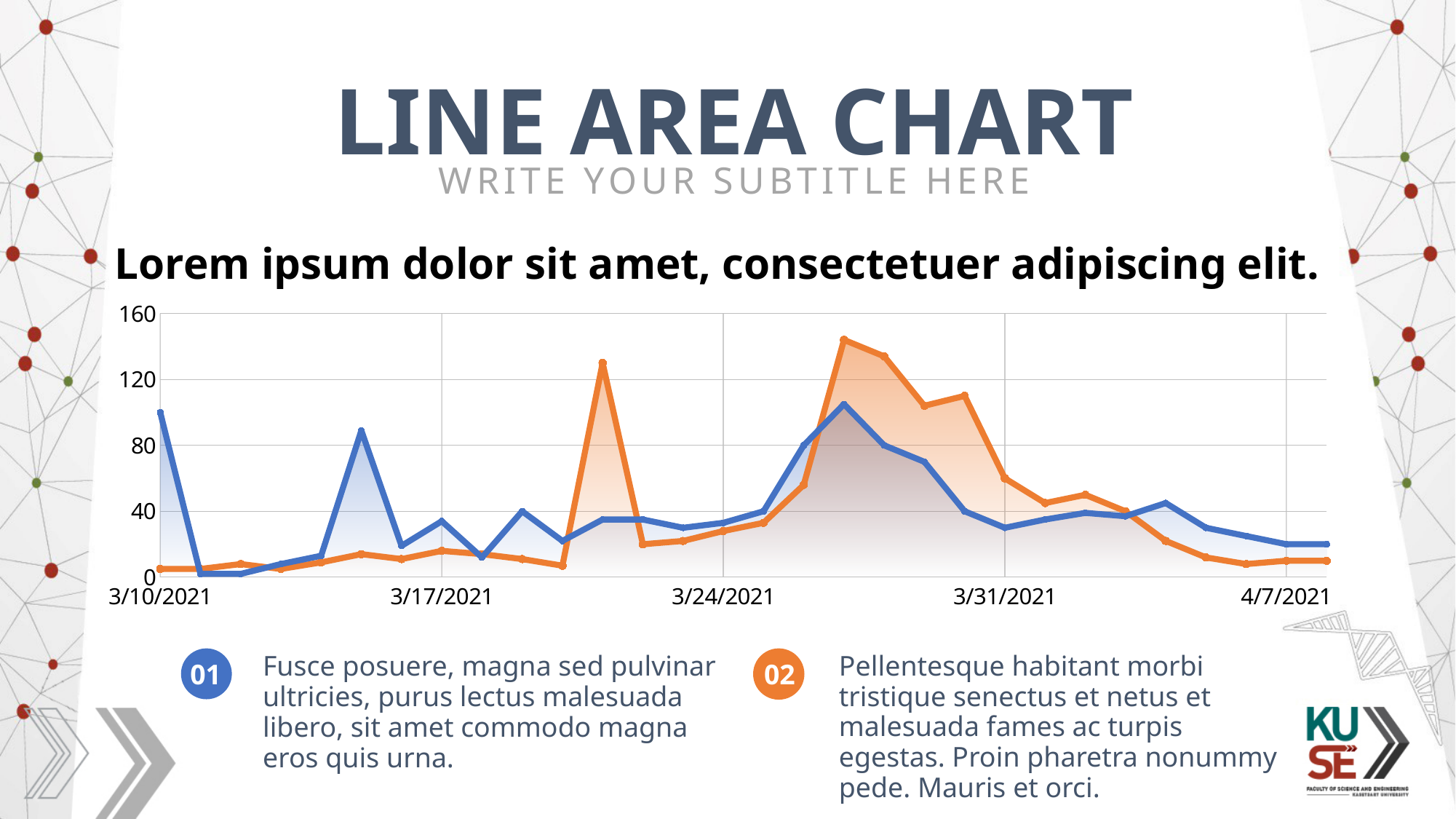
Is the value of the blue series at 3/10/2021 greater or less than 80? greater What kind of chart is shown on the slide? line area chart Is the peak value of the orange series greater or less than 120? greater Is the value of the blue series at 3/17/2021 greater or less than 40? less At 3/10/2021, which series has the larger value, the blue or the orange? blue How many date labels are shown on the x axis of the chart? 5 At 3/31/2021, which series has the larger value, the blue or the orange? orange What is the highest value shown on the y axis of the chart? 160 What is the title of the slide containing the chart? LINE AREA CHART